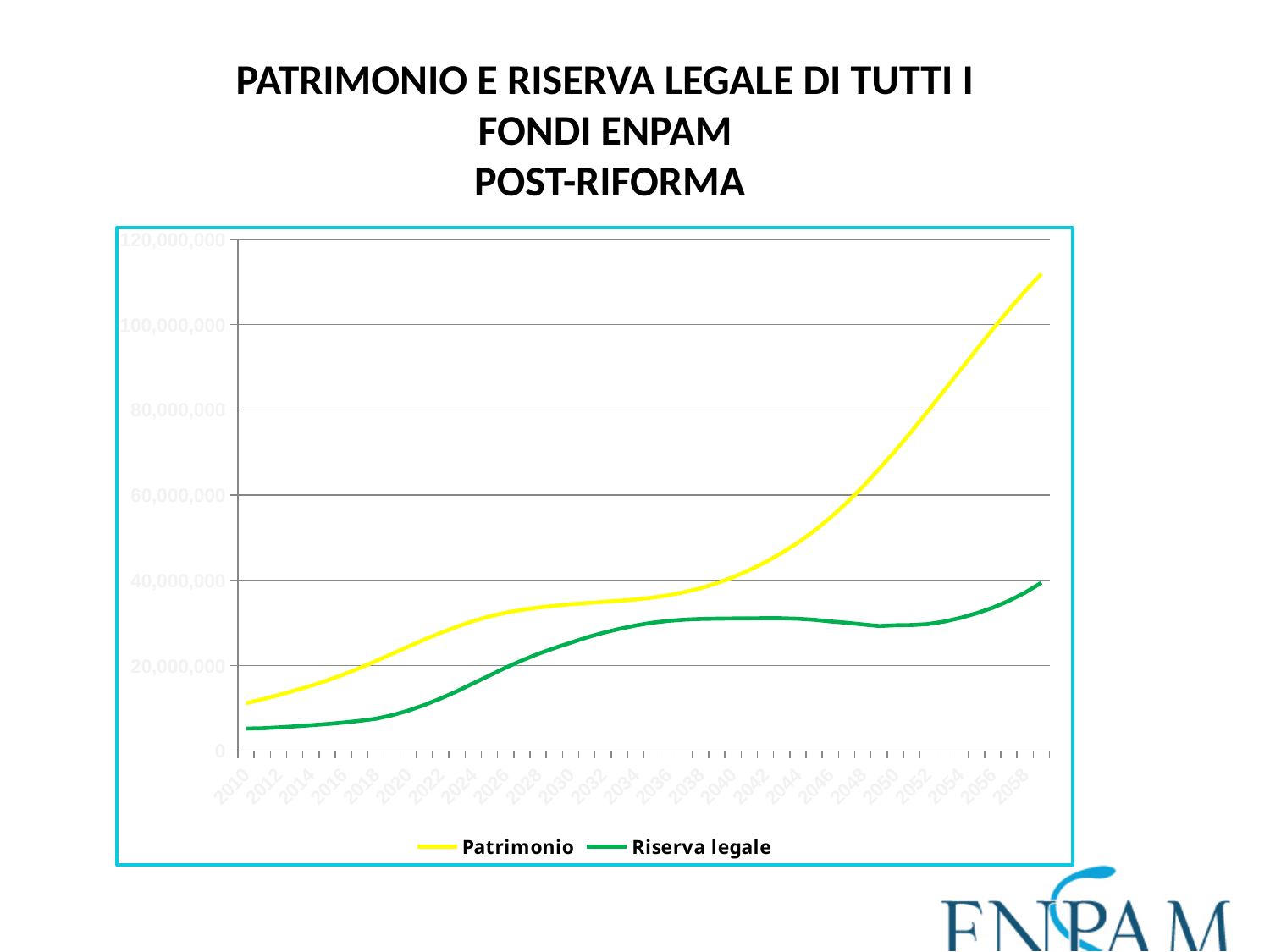
Which series stays lower than the other across the whole period shown? Riserva legale Is the value of Patrimonio in 2040 greater or less than 60,000,000? less What kind of chart is shown on the slide? line chart Which colour is used for the Patrimonio line? yellow What are the two series named in the legend? Patrimonio and Riserva legale Is the value of Patrimonio in 2010 greater or less than 20,000,000? less Is the value of Riserva legale in 2058 greater or less than 60,000,000? less How many series does the legend list? 2 Which series is higher in 2058, Patrimonio or Riserva legale? Patrimonio Does the Patrimonio line rise or fall overall from 2010 to 2058? rise